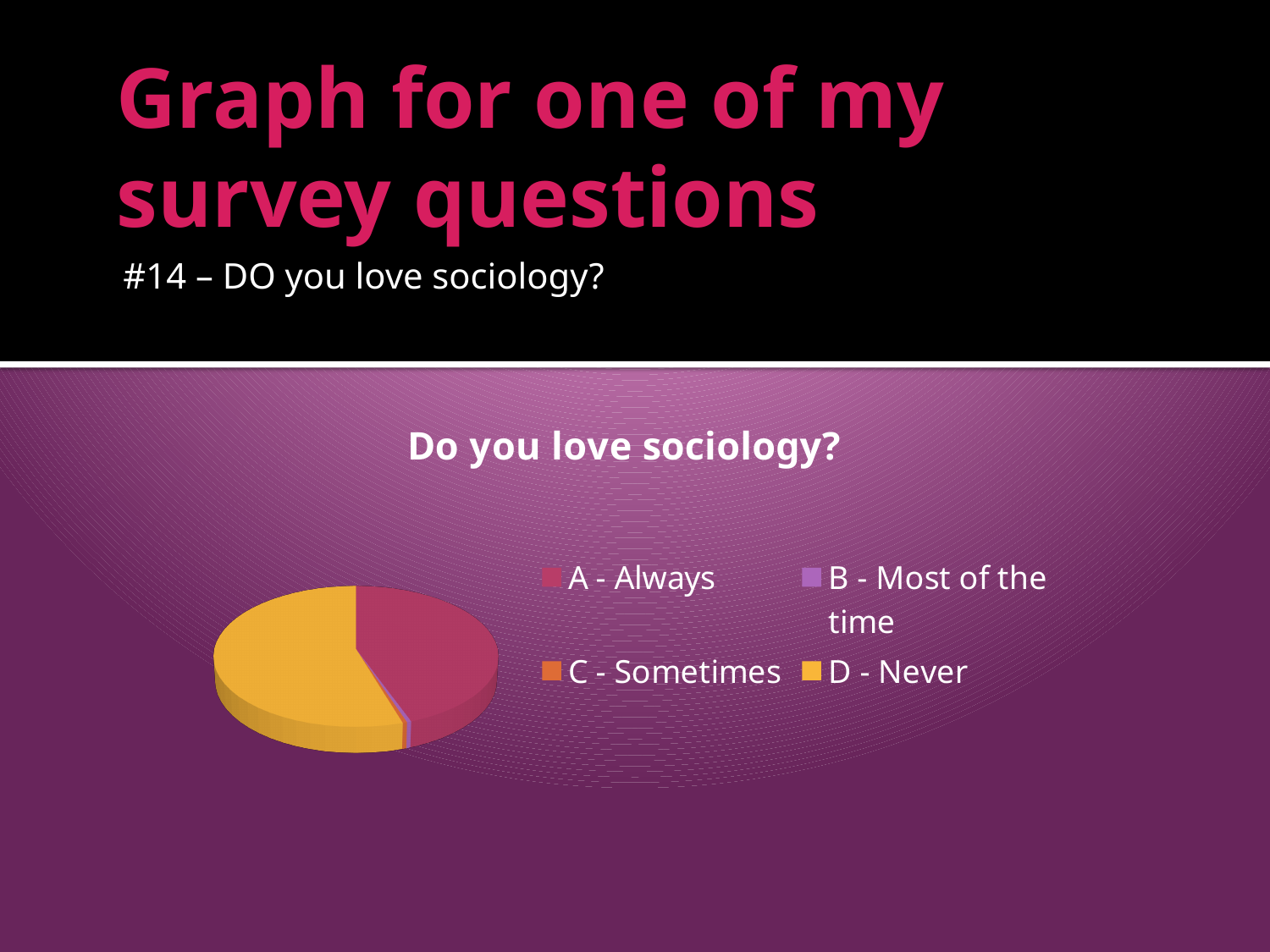
What is the title of the chart? Do you love sociology? Which legend entry is shown in yellow? D - Never Which slice is larger, D - Never or B - Most of the time? D - Never Which category has the largest slice of the pie? D - Never What kind of chart is shown on the slide? pie chart How many answer categories are shown in the pie chart legend? 4 How many entries does the chart legend list? 4 Which slice is larger, A - Always or B - Most of the time? A - Always